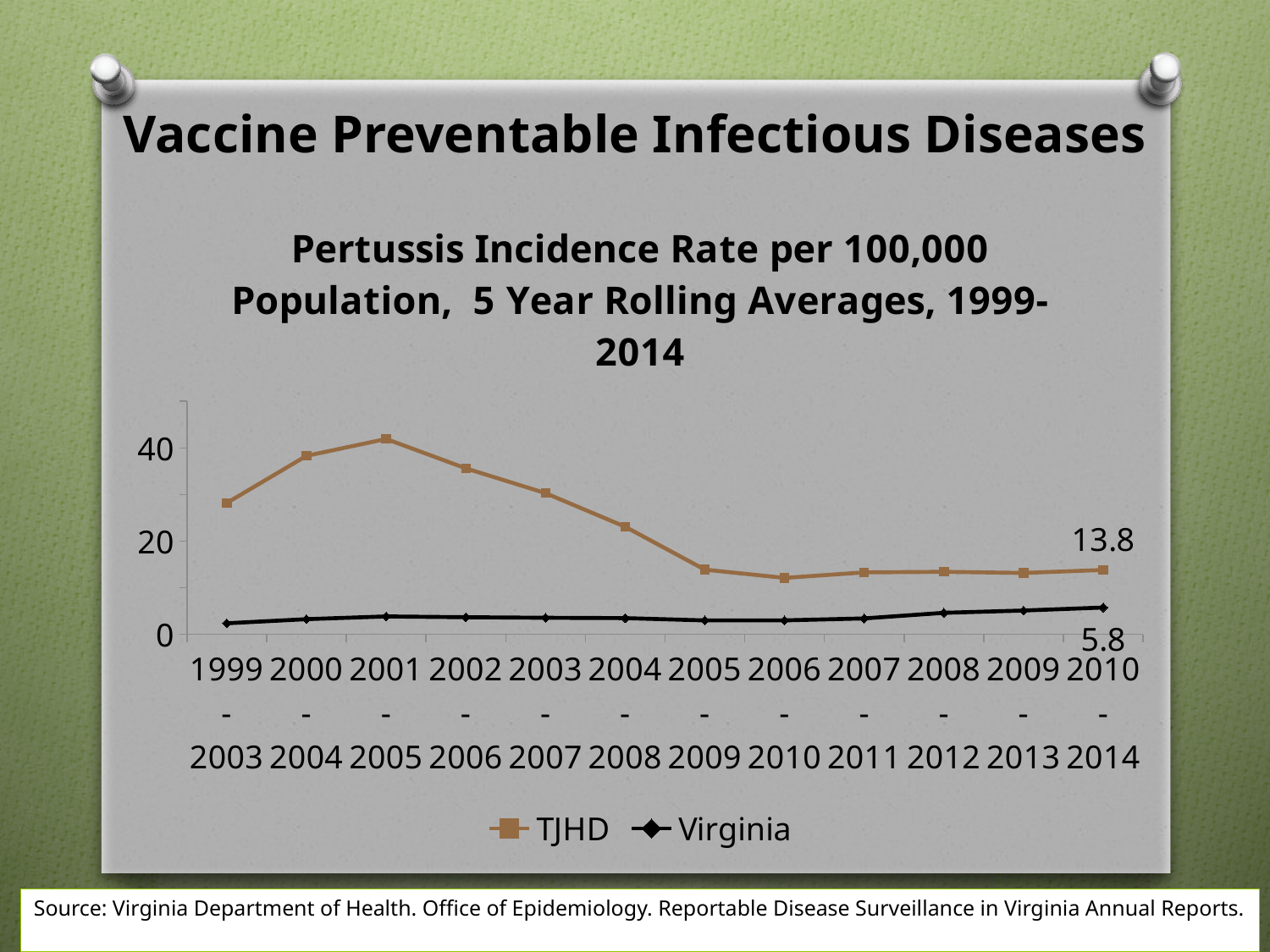
What is the Virginia pertussis incidence rate for the 2010-2014 period? 5.8 For the 2010-2014 period, which series has the higher value, TJHD or Virginia? TJHD In which period does the TJHD series reach its lowest value? 2006-2010 What kind of chart is shown on the slide? line chart Does the TJHD series rise or fall from 2001-2005 to 2006-2010? fall What is the difference between the TJHD and Virginia values for 2010-2014? 8.0 How many rolling-average periods are shown on the x axis? 12 Is the TJHD value for 1999-2003 greater or less than 20? greater Is the TJHD value for 2001-2005 greater or less than 40? greater In which period does the TJHD series reach its highest value? 2001-2005 What is the TJHD pertussis incidence rate for the 2010-2014 period? 13.8 How many series does the legend list? 2